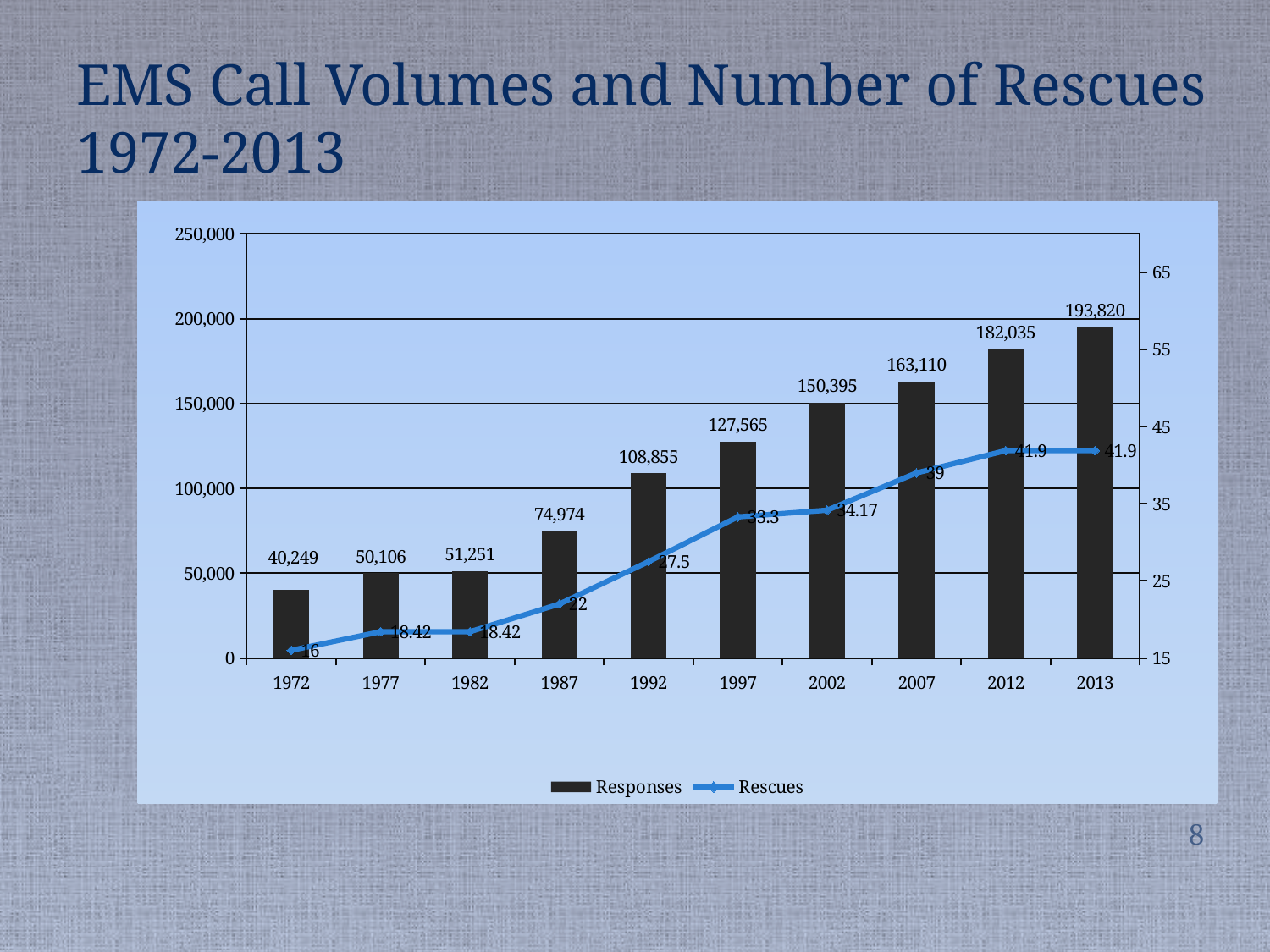
What is the difference in Responses between 2013 and 2012? 11,785 What is the value of Responses for 1992? 108,855 Which year has the highest number of Responses? 2013 What is the value of Rescues for 2007? 39 Which year has the lowest value for Rescues? 1972 How many series does the legend list? 2 What is the value of Responses for 1972? 40,249 How many years are shown on the x axis? 10 Is the value of Responses for 2002 greater or less than 100,000? greater Do the Responses values rise or fall from 1972 to 2013? rise Which is larger, Responses in 1987 or Responses in 1982? 1987 What kind of chart is used to show the Responses series? bar chart